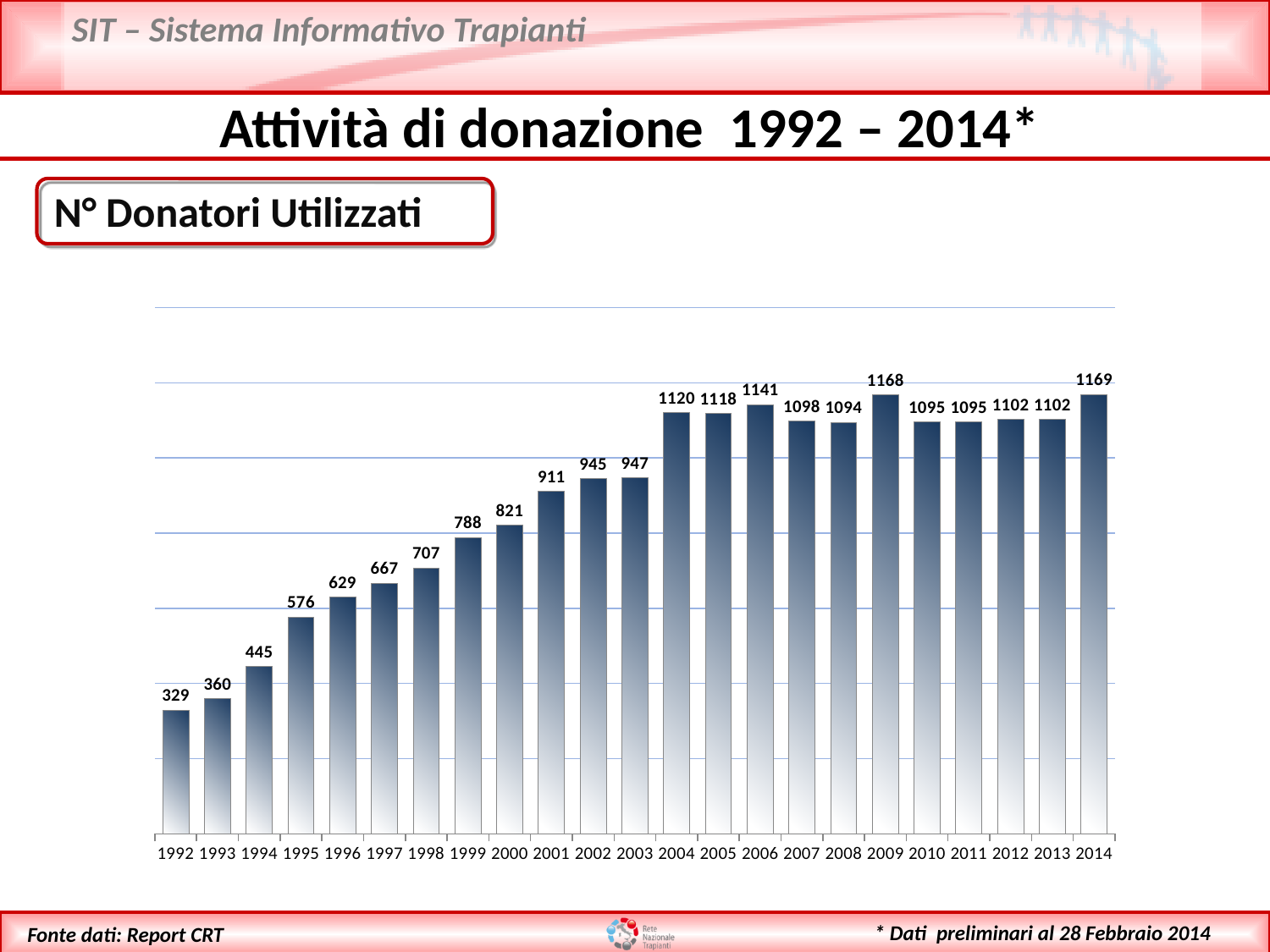
Which year has the lowest number of donors used? 1992 How many years (bars) are shown in the chart? 23 What is the difference between the values for 2009 and 2008? 74 What is the value for 2014 in the chart? 1169 What is the difference between the values for 2014 and 1992? 840 What value does the chart show for 2001? 911 Which year has the larger value, 2003 or 2004? 2004 What is the number of donors used (N° Donatori Utilizzati) in 1992? 329 What type of chart is used on the slide? Bar chart What is the overall trend of the values from 1992 to 2014? Rising Which year has the larger value, 1995 or 1999? 1999 What value is shown for 2004 in the N° Donatori Utilizzati chart? 1120